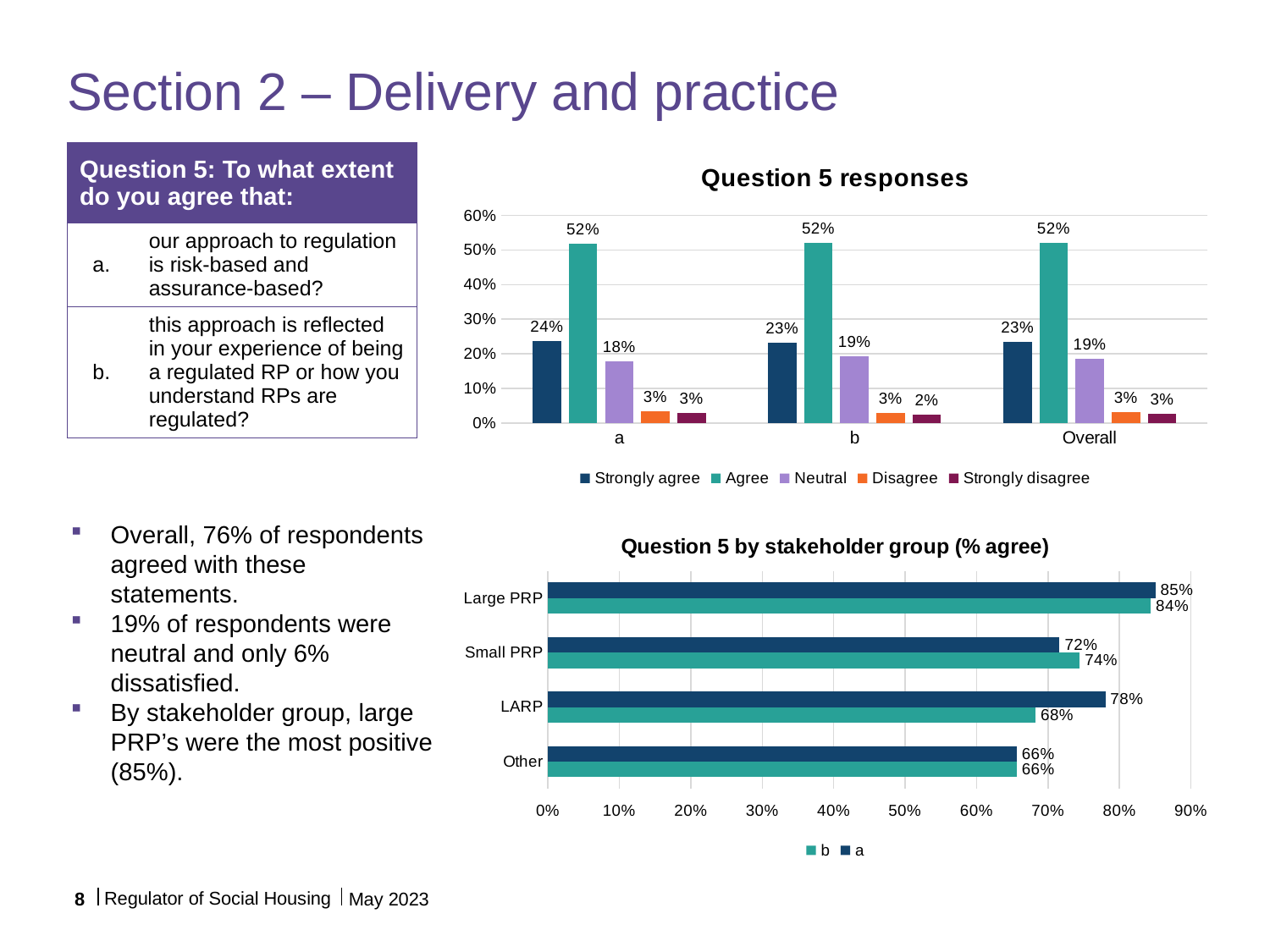
In the 'Question 5 by stakeholder group (% agree)' chart, what is the value for series a for Large PRP? 85% In the 'Question 5 responses' chart, how many series does the legend list? 5 What kind of chart is 'Question 5 by stakeholder group (% agree)'? Bar chart In the 'Question 5 by stakeholder group (% agree)' chart, which is larger for Small PRP, series a or series b? b In the 'Question 5 responses' chart, what is the value for Agree in the Overall category? 52% In the 'Question 5 by stakeholder group (% agree)' chart, how many stakeholder groups are shown? 4 In the 'Question 5 by stakeholder group (% agree)' chart, which stakeholder group has the lowest value for series a? Other In the 'Question 5 responses' chart, what is the difference between Agree and Neutral in the Overall category? 33% In the 'Question 5 responses' chart, what is the value for Strongly disagree for statement b? 2% In the 'Question 5 responses' chart, what is the value for Strongly agree for statement a? 24% In the 'Question 5 by stakeholder group (% agree)' chart, what is the value for series b for LARP? 68% In the 'Question 5 responses' chart, which response category has the highest value for statement b? Agree